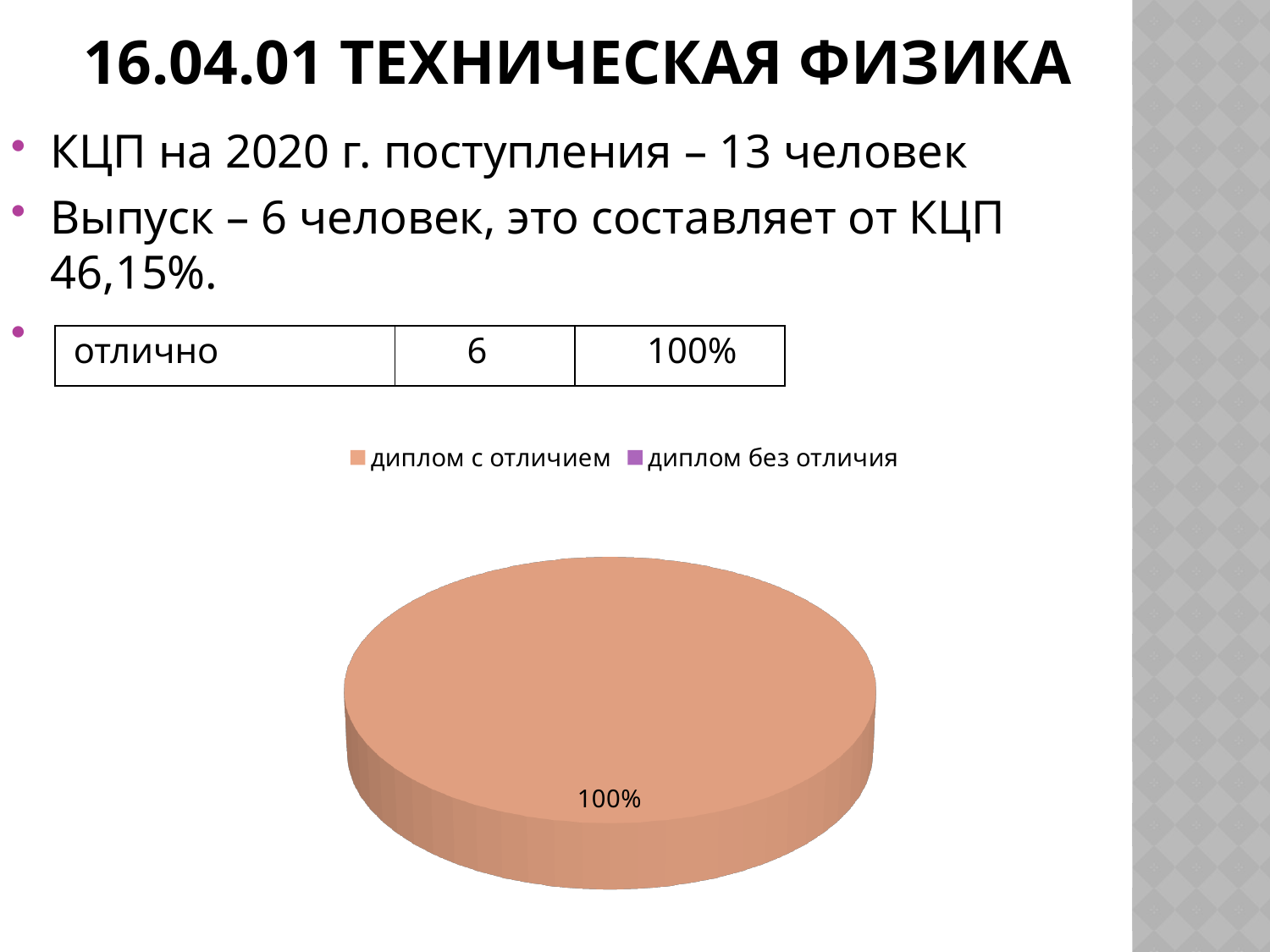
How many entries does the chart legend list? 2 What is the second legend entry of the chart? диплом без отличия What kind of chart is shown on the slide? pie chart Which legend entry corresponds to the slice that fills the entire pie? диплом с отличием What is the data label printed on the pie slice? 100% What share of the pie does the slice labelled on the chart represent? 100% Which category has the largest share of the pie? диплом с отличием What colour is the slice for диплом с отличием? orange Which of the two legend categories has the larger share: диплом с отличием or диплом без отличия? диплом с отличием How many visible slices does the pie have? 1